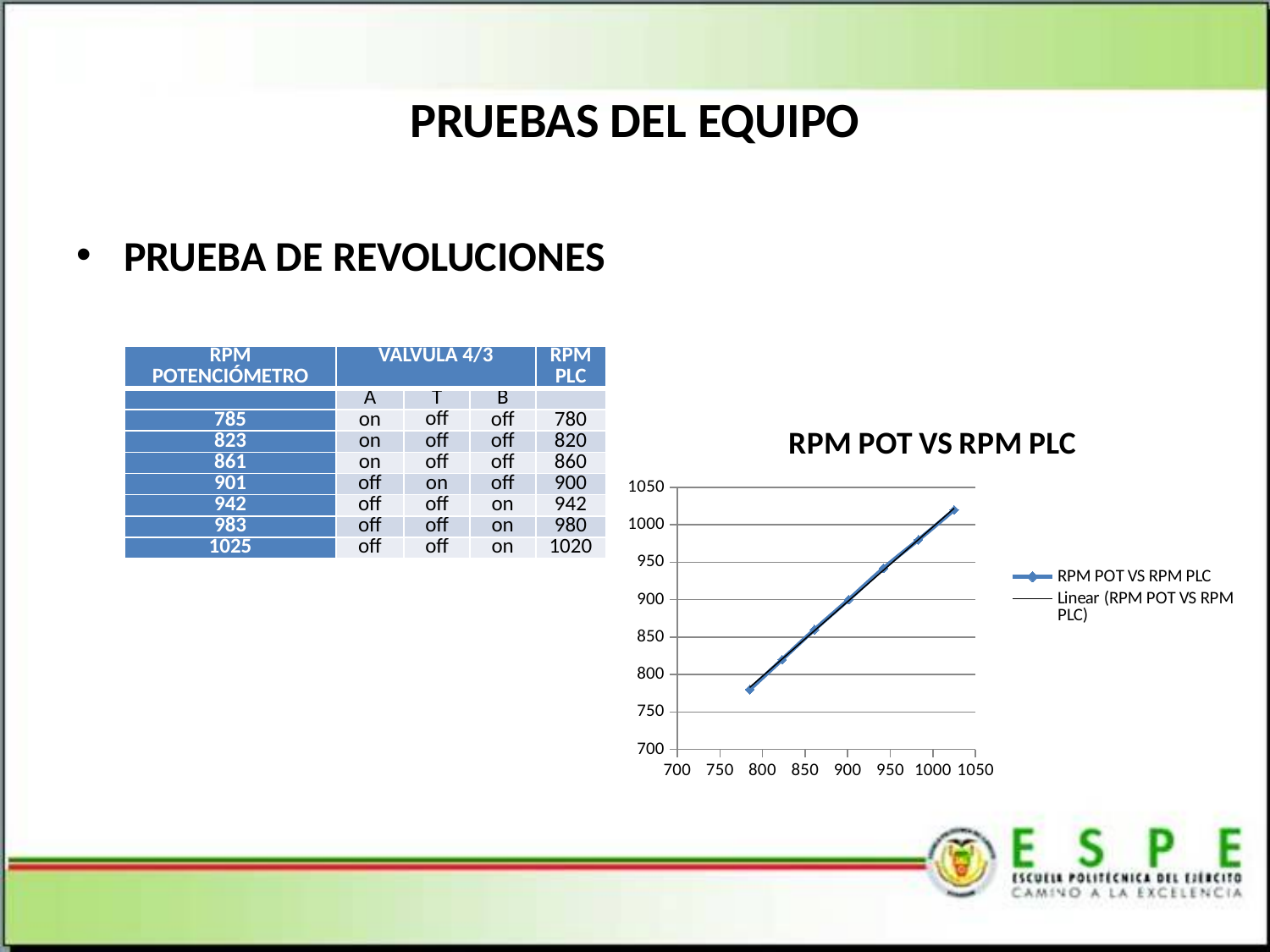
What kind of chart is shown on the slide? line chart Do the values in the RPM POT VS RPM PLC chart rise or fall as the x-axis value increases? rise What is the lowest value shown on the y-axis of the RPM POT VS RPM PLC chart? 700 In the RPM POT VS RPM PLC chart, is the value of the point near x = 825 greater or less than 850? less In the RPM POT VS RPM PLC chart, is the value of the point near x = 950 greater or less than 900? greater What is the title of the chart on the slide? RPM POT VS RPM PLC In the RPM POT VS RPM PLC chart, is the value of the leftmost point greater or less than 800? less How many entries does the legend of the RPM POT VS RPM PLC chart list? 2 What is the second legend entry in the RPM POT VS RPM PLC chart? Linear (RPM POT VS RPM PLC) In the RPM POT VS RPM PLC chart, which point has the highest value, the leftmost or the rightmost? the rightmost How many data points are plotted in the RPM POT VS RPM PLC chart? 7